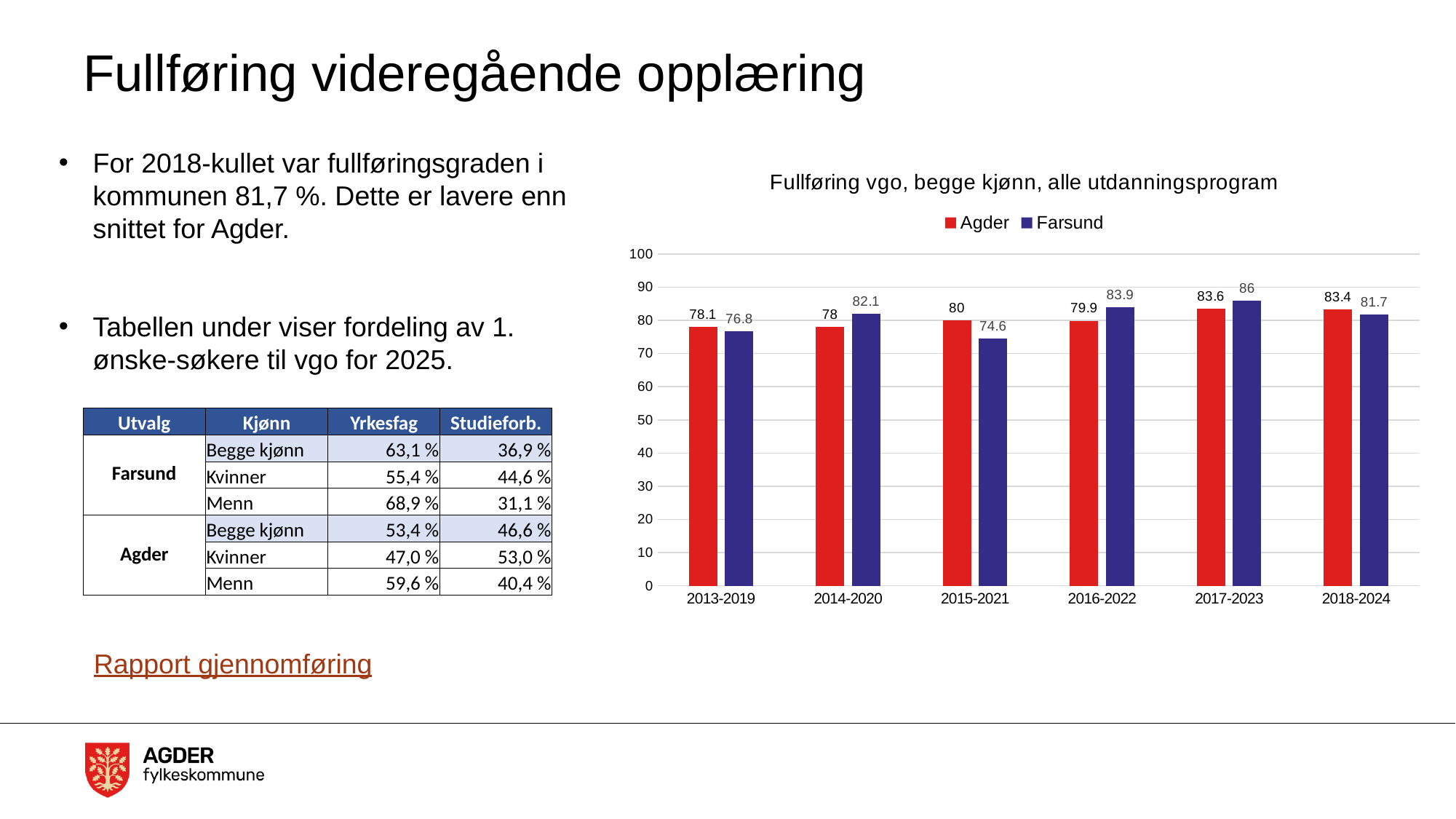
What kind of chart is shown? Bar chart What is the Farsund value for 2017-2023? 86 What is the difference between the Farsund and Agder values for 2015-2021? 5.4 What is the Agder value for 2015-2021? 80 In which period is the Farsund value lowest? 2015-2021 In which period is the Agder value highest? 2017-2023 What is the title of the chart? Fullføring vgo, begge kjønn, alle utdanningsprogram How many periods are shown on the x axis? 6 Is the Farsund value for 2016-2022 greater or less than 80? greater Which is larger for 2018-2024, Agder or Farsund? Agder How many series does the legend list? 2 What is the Farsund value for 2013-2019? 76.8